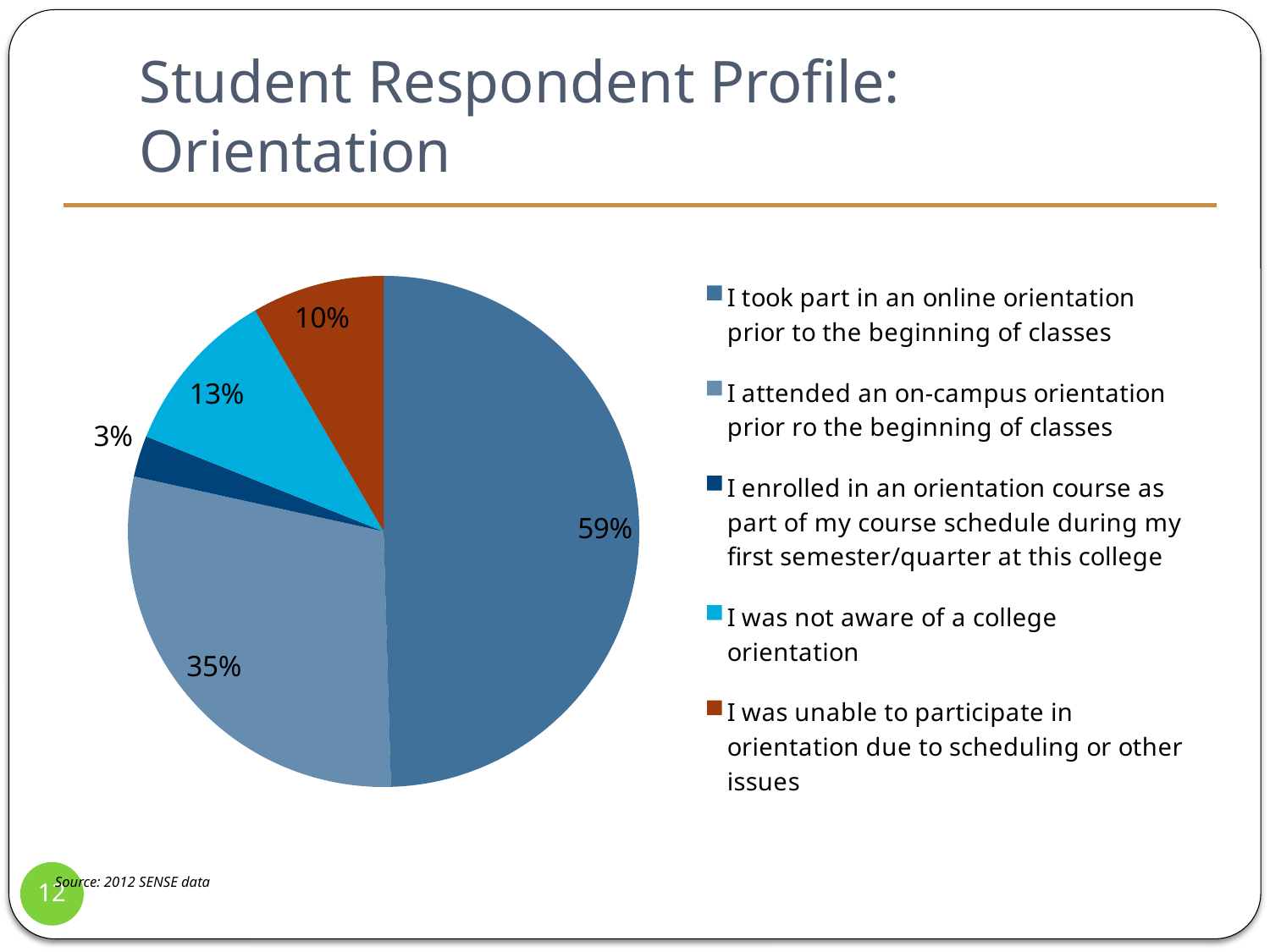
Which response category has the smallest slice of the pie? I enrolled in an orientation course as part of my course schedule during my first semester/quarter at this college What share of respondents took part in an online orientation prior to the beginning of classes? 59% What share of respondents were unable to participate in orientation due to scheduling or other issues? 10% What is the title of the slide containing the pie chart? Student Respondent Profile: Orientation How many slices does the pie chart have? 5 What is the difference in percentage points between the online orientation slice and the on-campus orientation slice? 24 What share of respondents enrolled in an orientation course as part of their course schedule during their first semester/quarter? 3% Which response category has the largest slice of the pie? I took part in an online orientation prior to the beginning of classes What kind of chart is shown on the slide? pie chart What share of respondents attended an on-campus orientation prior to the beginning of classes? 35% What share of respondents were not aware of a college orientation? 13% Which is larger: the share who were not aware of a college orientation or the share who were unable to participate due to scheduling or other issues? I was not aware of a college orientation